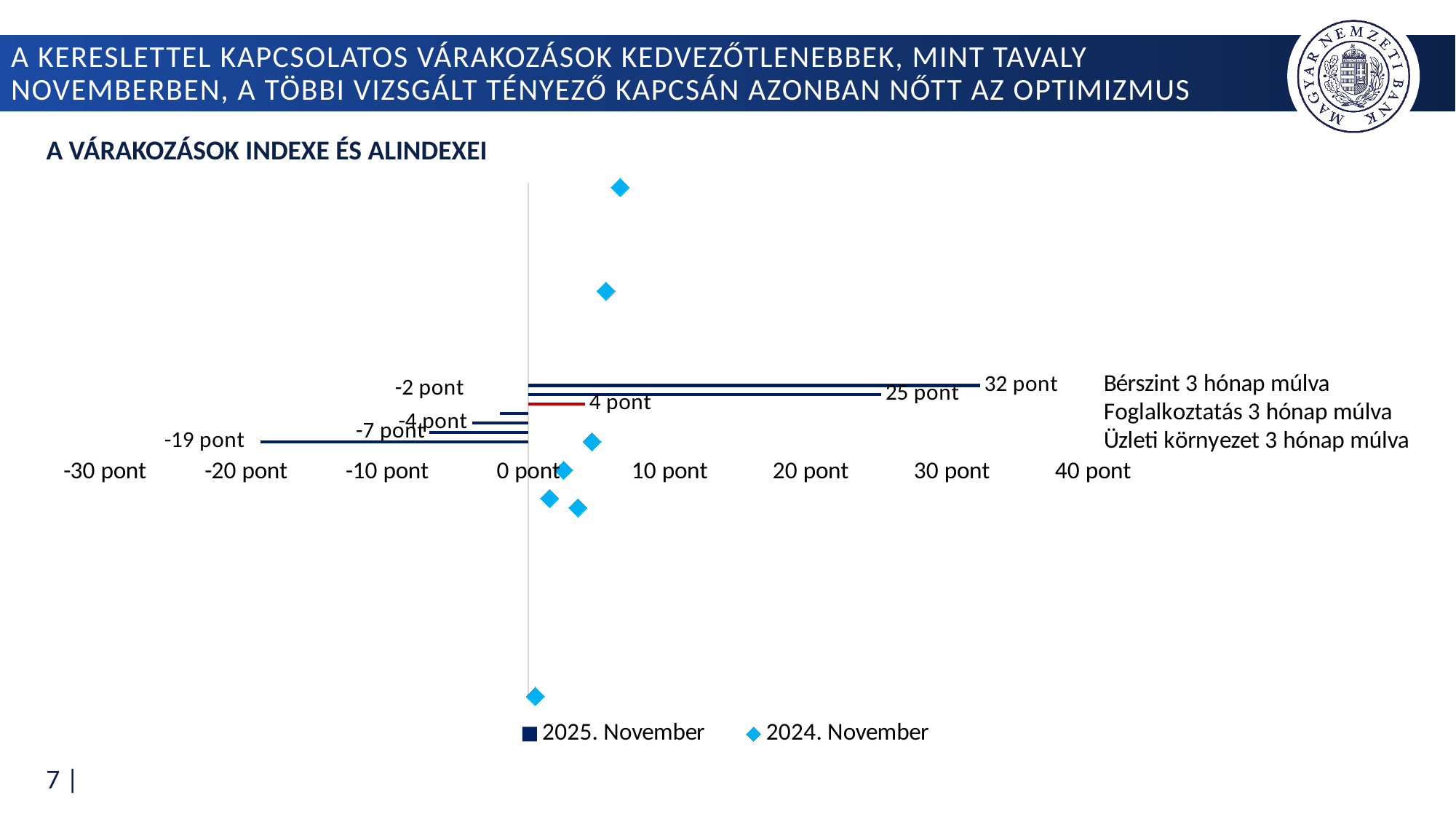
Is the longest 2025. November bar greater or less than 30 pont? greater How many series does the chart legend list? 2 What is the highest labelled value among the 2025. November bars? 32 pont What kind of chart is used to show the 2025. November values? Bar chart How many of the labelled 2025. November bars have negative values? 4 How many 2025. November bars have data labels on the chart? 7 What is the difference between the two largest labelled 2025. November values, 32 pont and 25 pont? 7 pont Is the 2025. November bar labelled -19 pont greater or less than -10 pont? less What is the title of the chart? A VÁRAKOZÁSOK INDEXE ÉS ALINDEXEI Which is larger among the 2025. November bars: the bar labelled 32 pont or the bar labelled 25 pont? 32 pont Which two series are listed in the chart legend? 2025. November and 2024. November What is the lowest labelled value among the 2025. November bars? -19 pont